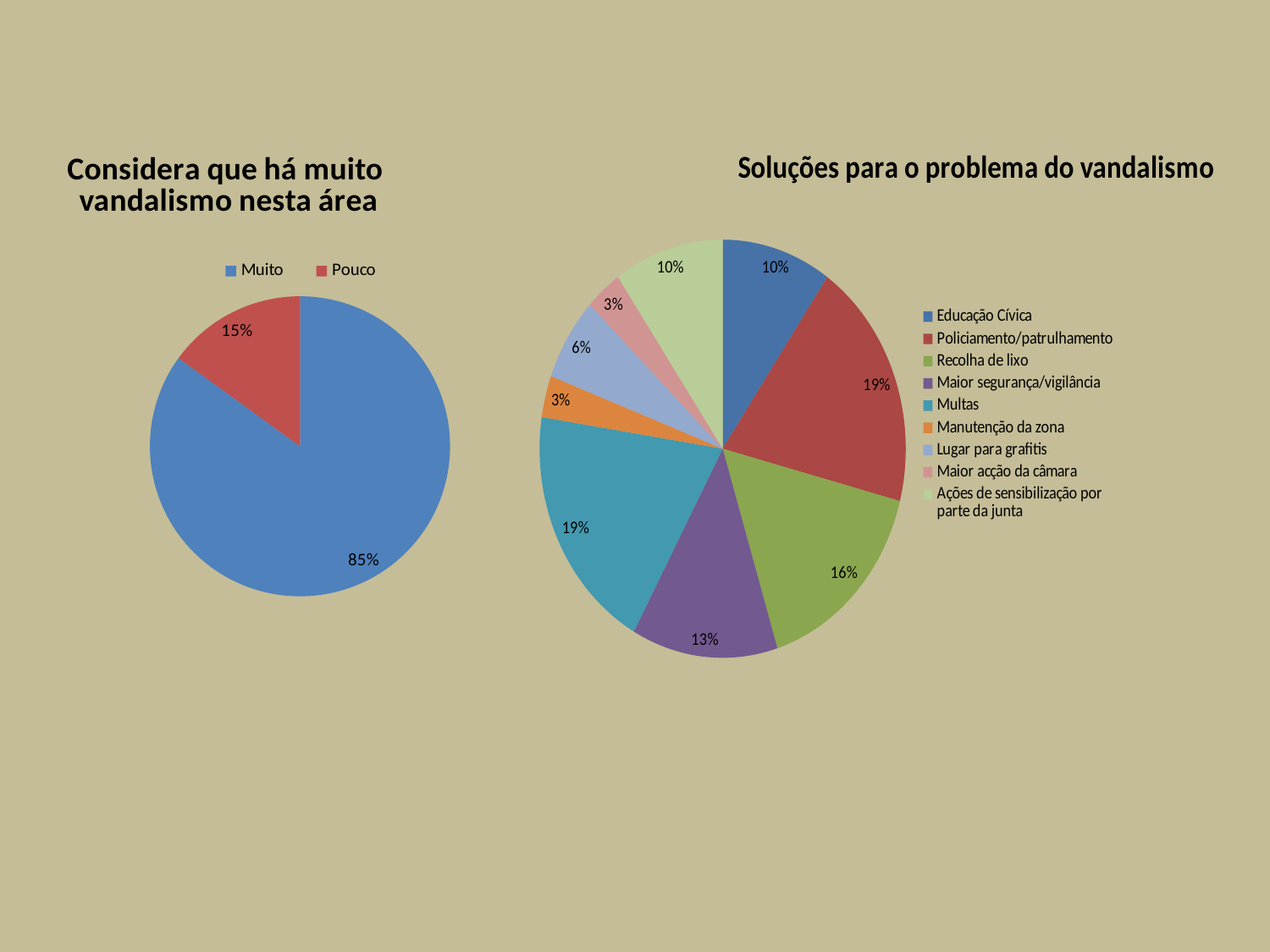
In the chart titled "Soluções para o problema do vandalismo", what percentage is shown for Lugar para grafitis? 6% In the chart titled "Soluções para o problema do vandalismo", what percentage is shown for Recolha de lixo? 16% In the chart titled "Considera que há muito vandalismo nesta área", which category has the largest share? Muito What type of chart is the one titled "Considera que há muito vandalismo nesta área"? Pie chart In the chart titled "Soluções para o problema do vandalismo", what percentage is shown for Maior segurança/vigilância? 13% In the chart titled "Soluções para o problema do vandalismo", what percentage is shown for Educação Cívica? 10% In the chart titled "Soluções para o problema do vandalismo", what is the difference in percentage points between Multas and Manutenção da zona? 16 In the chart titled "Soluções para o problema do vandalismo", which is larger: Recolha de lixo or Maior segurança/vigilância? Recolha de lixo In the chart titled "Considera que há muito vandalismo nesta área", what is the difference in percentage points between Muito and Pouco? 70 In the chart titled "Considera que há muito vandalismo nesta área", what percentage is shown for Pouco? 15% In the chart titled "Considera que há muito vandalismo nesta área", what percentage is shown for Muito? 85% In the chart titled "Soluções para o problema do vandalismo", how many categories does the legend list? 9